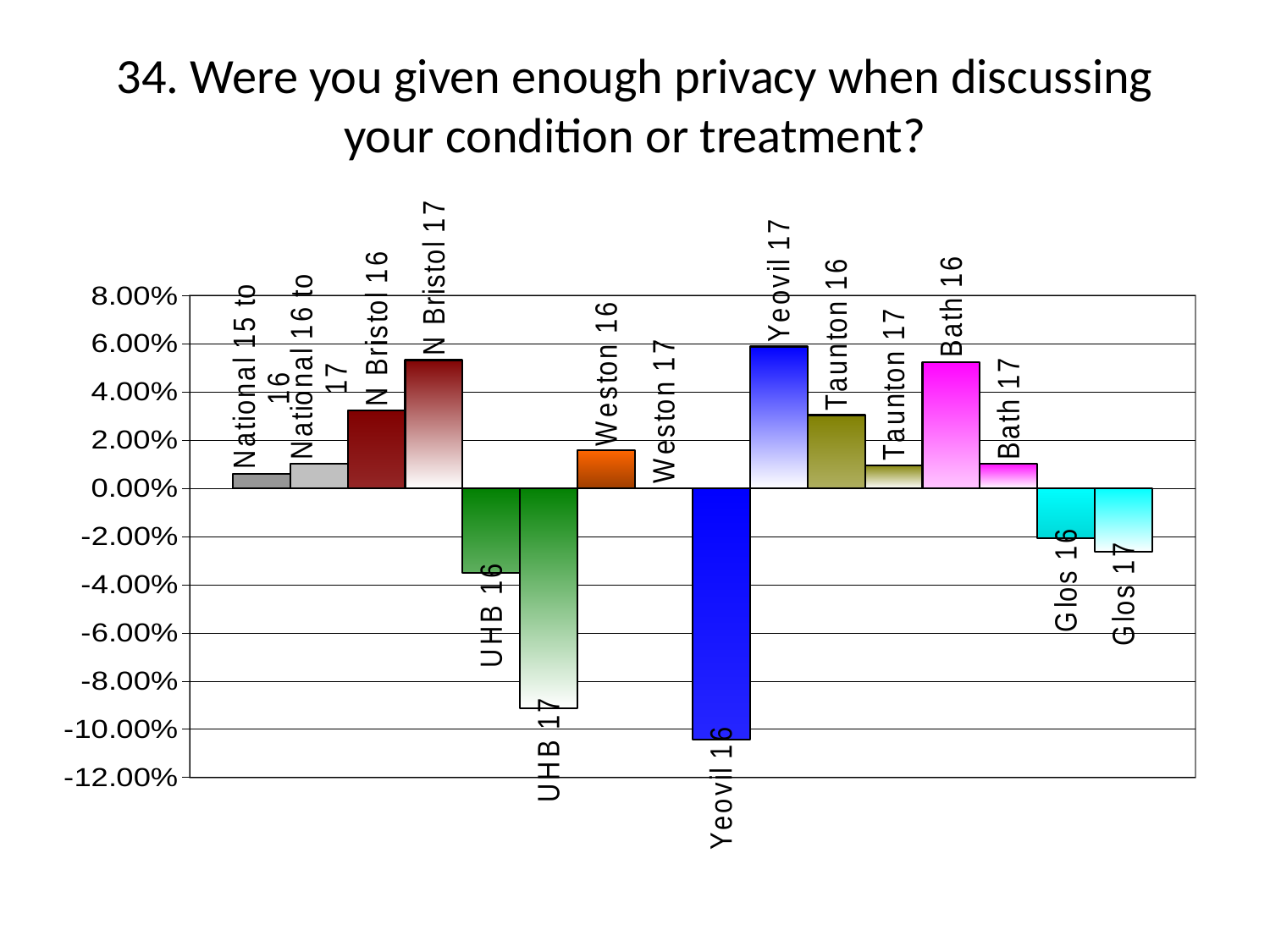
Which is larger, the value for N Bristol 16 or N Bristol 17? N Bristol 17 Is the value for N Bristol 16 greater or less than 2.00%? greater Is the value for Yeovil 16 greater or less than -10.00%? less Which is larger, the value for Bath 16 or Bath 17? Bath 16 What kind of chart is shown on the slide? bar chart Which category has the lowest value on the chart? Yeovil 16 Is the value for Bath 16 greater or less than 4.00%? greater How many categories are plotted on the chart? 16 What is the title of the chart on the slide? 34. Were you given enough privacy when discussing your condition or treatment? Which category has the highest value on the chart? Yeovil 17